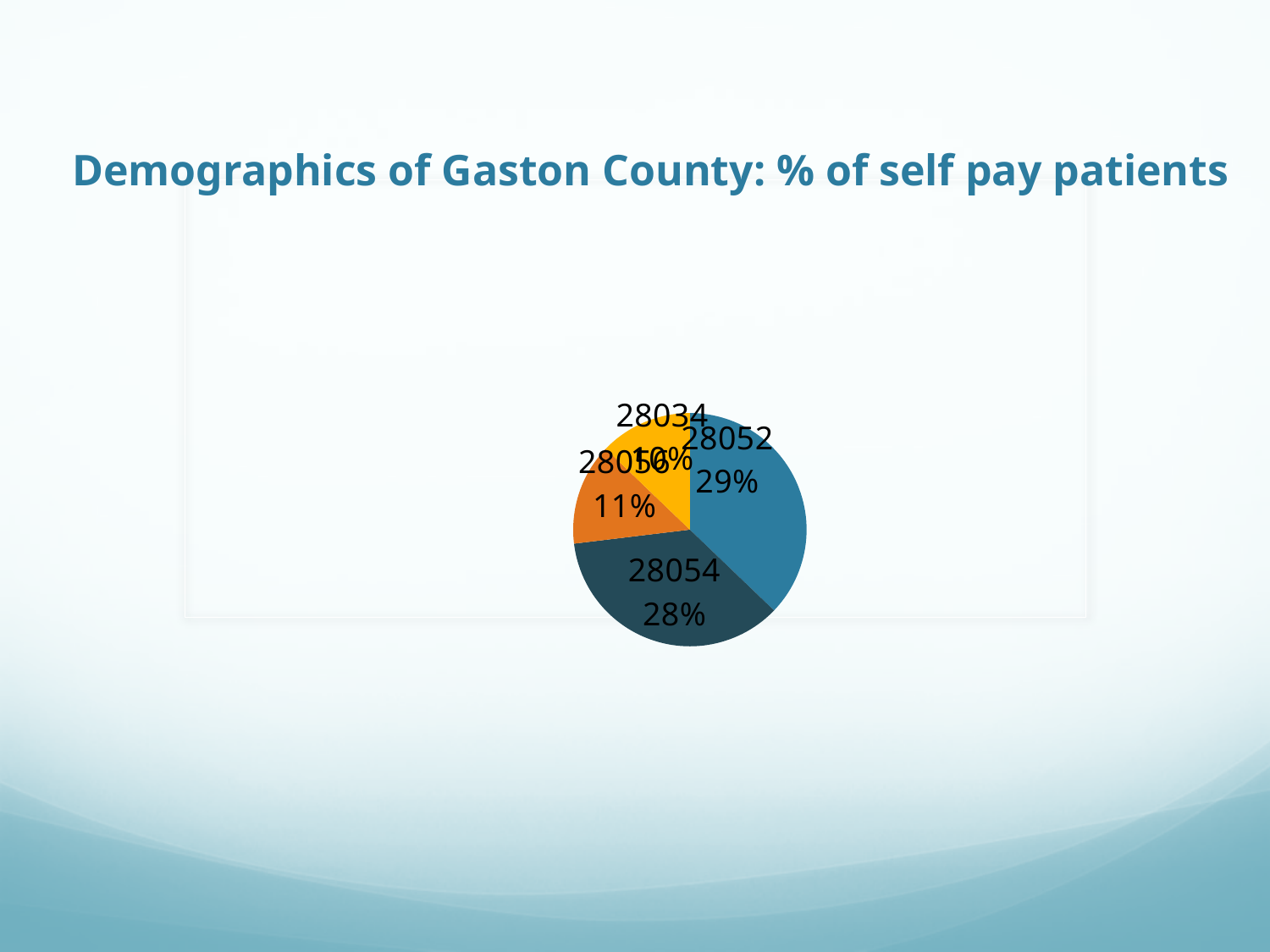
What is the difference in percentage points between the 28052 slice and the 28054 slice? 1 Which is larger, the 28052 slice or the 28054 slice? 28052 What colour is the 28052 slice? blue What percentage is shown for the 28052 slice? 29% How many slices does the pie chart have? 4 Which is larger, the 28054 slice or the 28056 slice? 28054 What percentage is shown for the 28054 slice? 28% What is the title of the slide containing the pie chart? Demographics of Gaston County: % of self pay patients Which slice has the highest percentage label? 28052 What kind of chart is shown on the slide? pie chart What percentage is shown for the 28056 slice? 11%